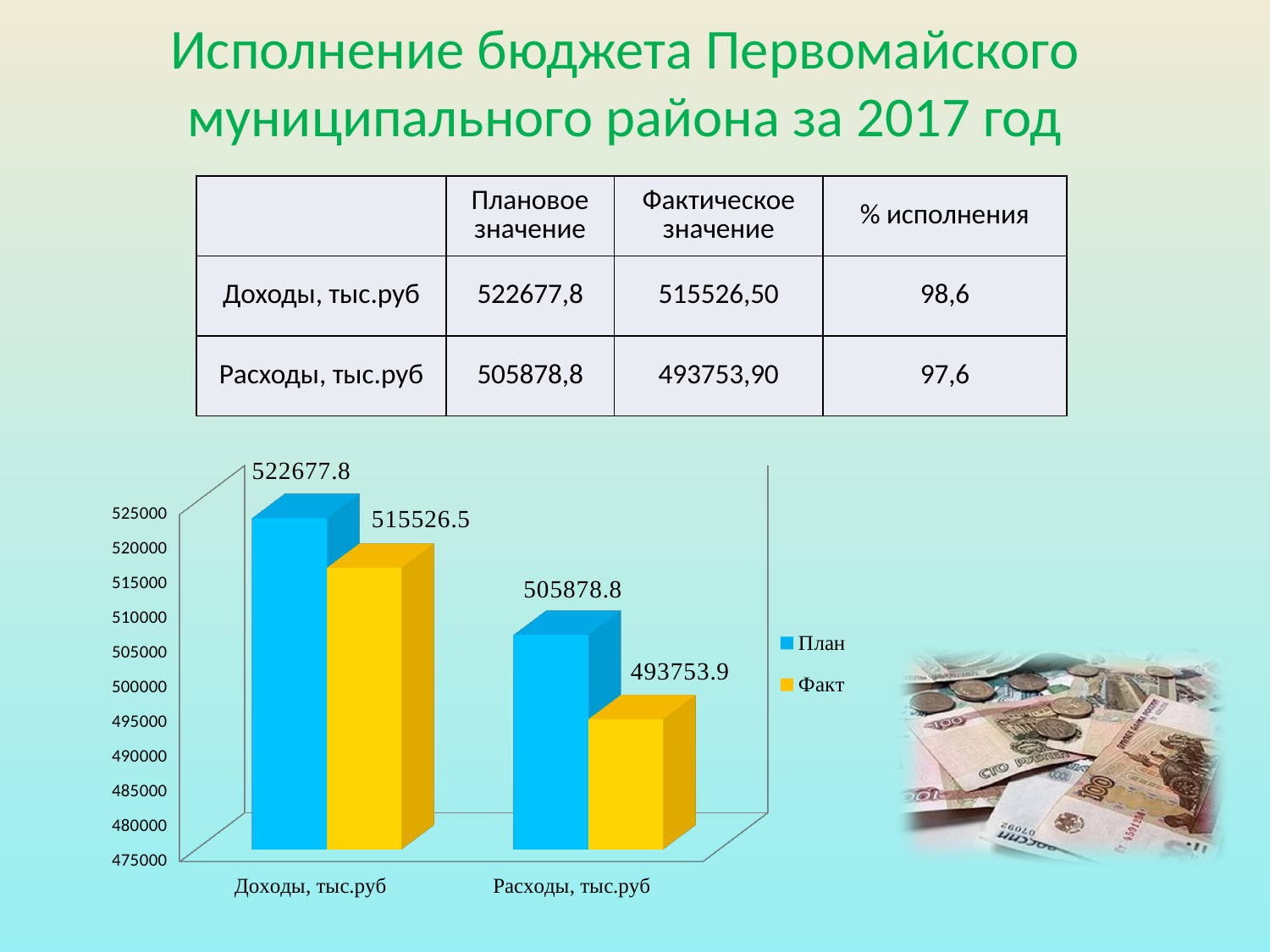
How many series does the chart legend list? 2 What is the Факт value for Расходы, тыс.руб in the chart? 493753.9 What is the difference between the План and Факт values for Доходы, тыс.руб in the chart? 7151.3 How many categories are shown on the x axis of the chart? 2 What is the Факт value for Доходы, тыс.руб in the chart? 515526.5 Which bar in the chart has the highest value? План for Доходы, тыс.руб What is the План value for Расходы, тыс.руб in the chart? 505878.8 What is the План value for Доходы, тыс.руб in the chart? 522677.8 What type of chart is shown on the slide? Bar chart What is the difference between the План and Факт values for Расходы, тыс.руб in the chart? 12124.9 In the chart, which is larger: the Факт value for Доходы, тыс.руб or the План value for Расходы, тыс.руб? Факт value for Доходы, тыс.руб Which bar in the chart has the lowest value? Факт for Расходы, тыс.руб